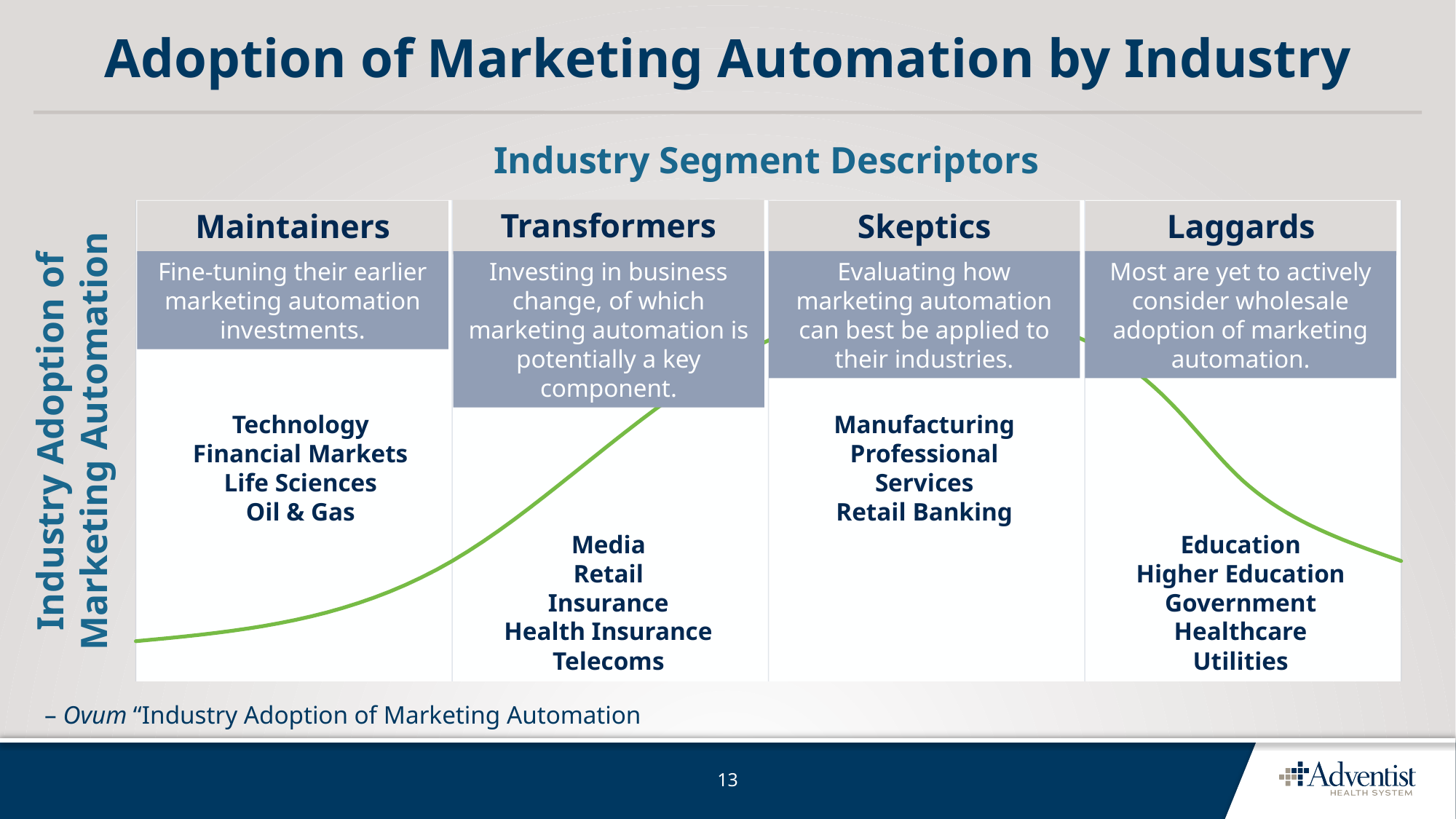
Does the curve rise or fall across the Laggards segment? Fall What is the heading above the four segment columns? Industry Segment Descriptors Which segment is at the lowest point of the curve? Maintainers Which segment lists Technology, Financial Markets, Life Sciences and Oil & Gas? Maintainers What is the label on the vertical axis of the chart? Industry Adoption of Marketing Automation Which is higher on the curve, Skeptics or Laggards? Skeptics How many industries are listed under the Laggards segment? 5 How many industry segments are shown along the x axis of the chart? 4 Which is higher on the curve, Transformers or Maintainers? Transformers What kind of chart is shown on the slide? Line chart Which segment lists Manufacturing, Professional Services and Retail Banking? Skeptics Does the curve rise or fall from the Maintainers segment to the Transformers segment? Rise